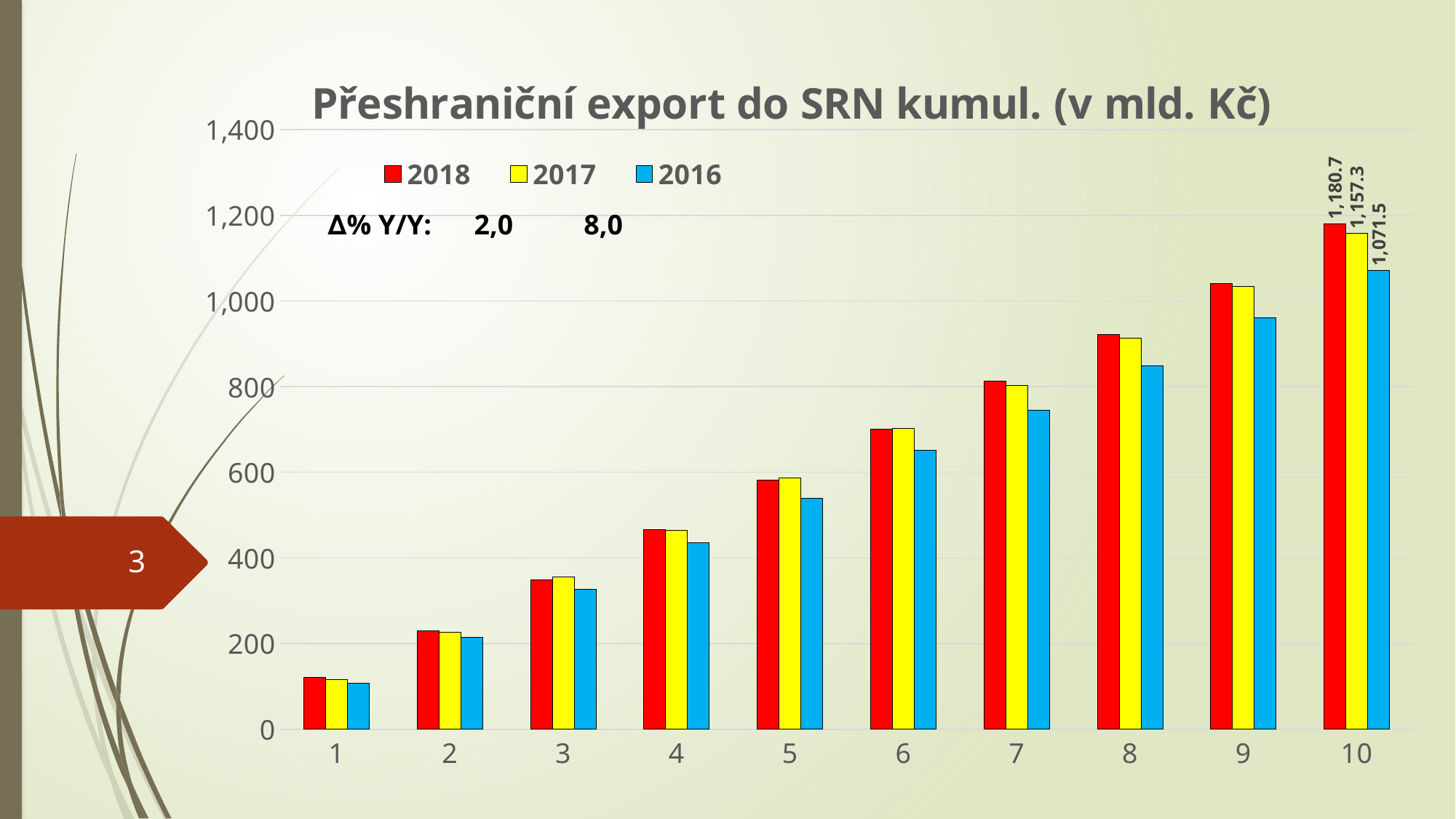
How many categories are shown on the x axis? 10 Do the values for the 2018 series rise or fall from category 1 to category 10? rise How many series does the legend list? 3 What is the value for 2017 at category 10? 1,157.3 What is the value for 2016 at category 10? 1,071.5 Is the value for 2016 at category 5 greater or less than 600? less At category 10, what is the difference between the 2018 value and the 2016 value? 109.2 At category 10, which series has the larger value, 2018 or 2016? 2018 Is the value for 2018 at category 9 greater or less than 1,000? greater What kind of chart is shown on the slide? bar chart What is the value for 2018 at category 10? 1,180.7 At category 10, what is the difference between the 2017 value and the 2016 value? 85.8